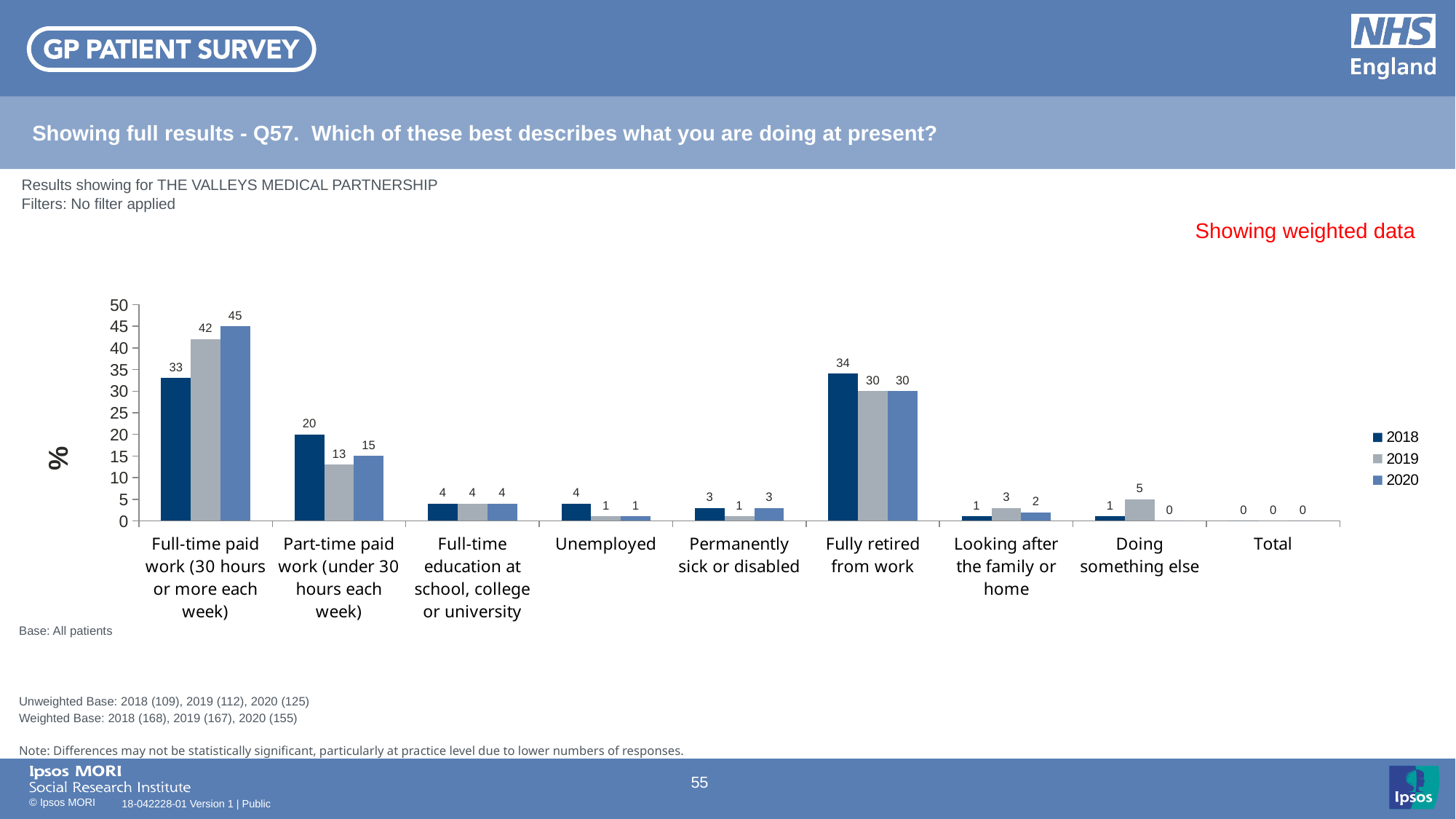
Which category has the highest 2020 value? Full-time paid work (30 hours or more each week) What is the 2018 value for Fully retired from work? 34 How did the value for Part-time paid work (under 30 hours each week) change from 2018 to 2019? It fell from 20 to 13 What is the 2020 value for Full-time paid work (30 hours or more each week)? 45 What is the difference between the 2018 and 2020 values for Full-time paid work (30 hours or more each week)? 12 How many series does the legend list? 3 What is the 2019 value for Part-time paid work (under 30 hours each week)? 13 What is the difference between the 2019 and 2020 values for Looking after the family or home? 1 What is the 2019 value for Doing something else? 5 What label is shown on the vertical axis? % What kind of chart is shown on the slide? Bar chart Which is larger: the 2018 value for Unemployed or the 2018 value for Permanently sick or disabled? Unemployed